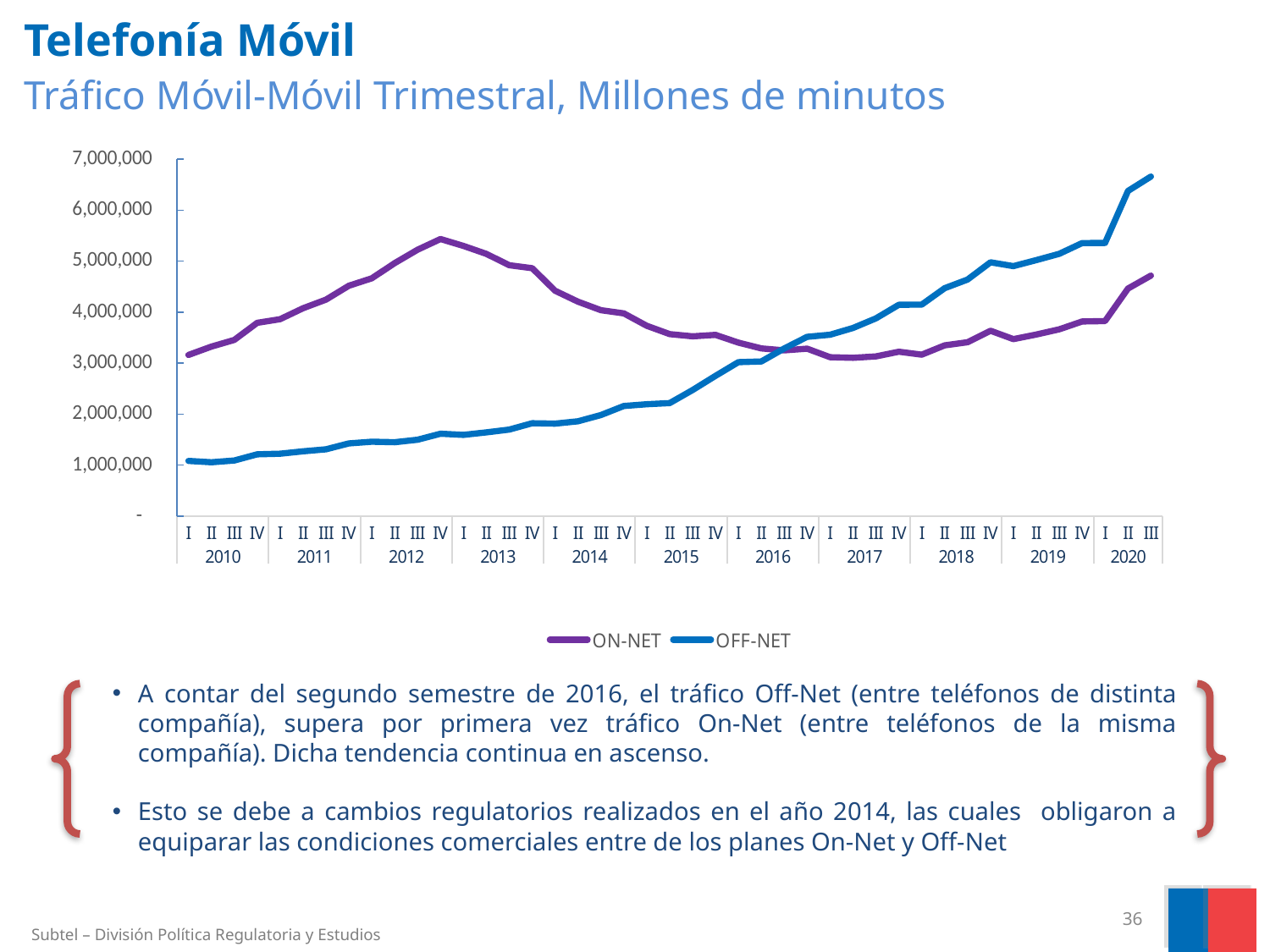
Which series is larger in quarter I of 2010, ON-NET or OFF-NET? ON-NET Is the ON-NET value for quarter IV of 2012 greater or less than 5,000,000? greater What is the title of the chart? Tráfico Móvil-Móvil Trimestral, Millones de minutos Which series reaches the highest value anywhere on the chart? OFF-NET Does the OFF-NET series generally rise or fall from 2010 to 2020? rise Is the OFF-NET value for quarter I of 2014 greater or less than 2,000,000? less What kind of chart is shown on the slide? line chart Which series is larger in quarter III of 2020, ON-NET or OFF-NET? OFF-NET Which two series are shown in the legend? ON-NET and OFF-NET Is the OFF-NET value for quarter III of 2020 greater or less than 6,000,000? greater How many series does the legend list? 2 How many quarterly points are plotted for each series (from I 2010 to III 2020)? 43